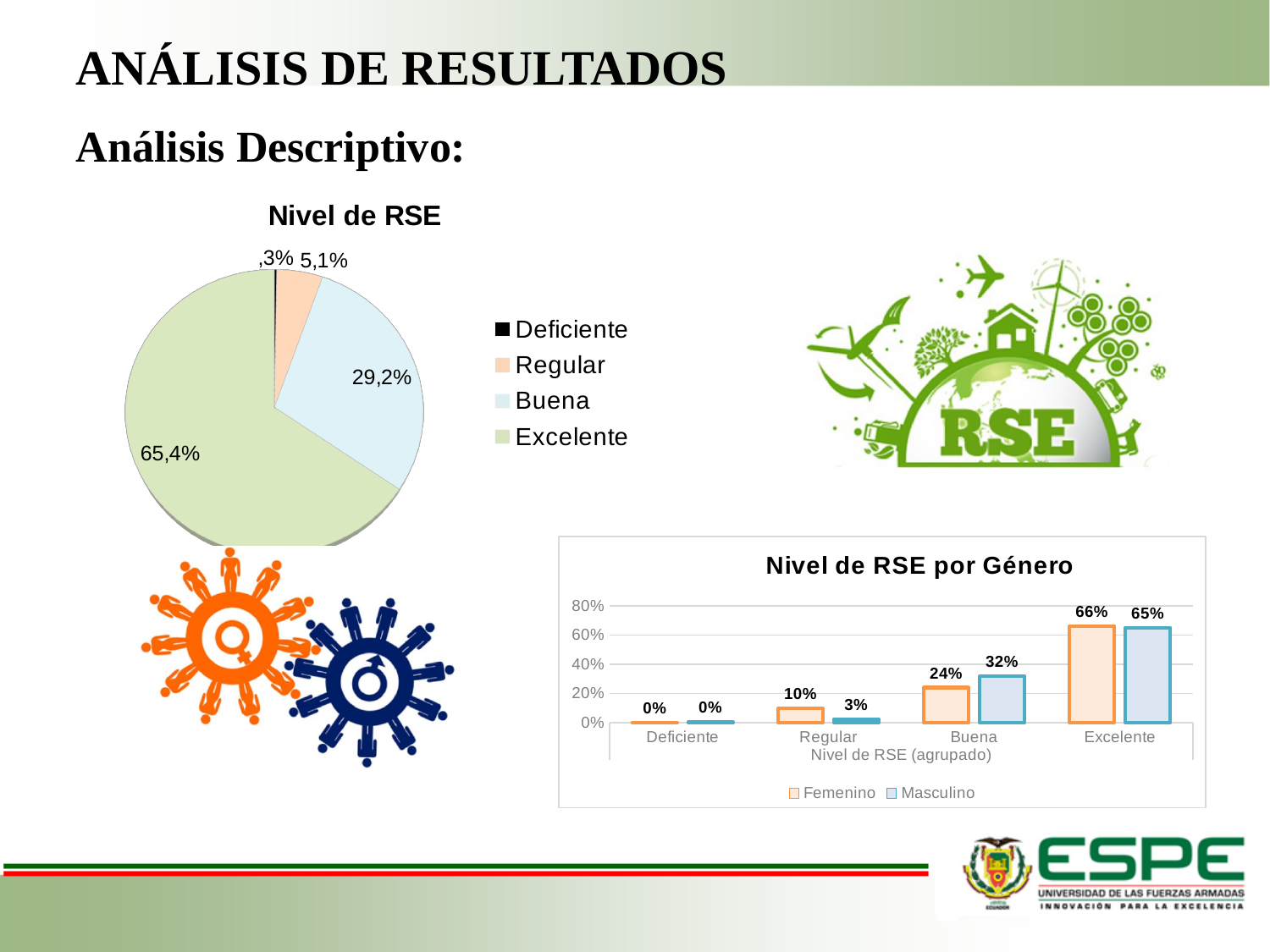
In the 'Nivel de RSE por Género' chart, what is the value for Femenino in the Buena category? 24% In the 'Nivel de RSE' pie chart, what share does Regular have? 5,1% In the 'Nivel de RSE' pie chart, how many categories does the legend list? 4 In the 'Nivel de RSE por Género' chart, what is the value for Masculino in the Regular category? 3% In the 'Nivel de RSE por Género' chart, what is the difference between Masculino and Femenino in the Buena category? 8% In the 'Nivel de RSE' pie chart, which category has the largest slice? Excelente What kind of chart is 'Nivel de RSE'? Pie chart What kind of chart is 'Nivel de RSE por Género'? Bar chart In the 'Nivel de RSE por Género' chart, how many series does the legend list? 2 In the 'Nivel de RSE por Género' chart, which is larger in the Regular category, Femenino or Masculino? Femenino In the 'Nivel de RSE' pie chart, what share does Excelente have? 65,4% In the 'Nivel de RSE' pie chart, what share does Buena have? 29,2%